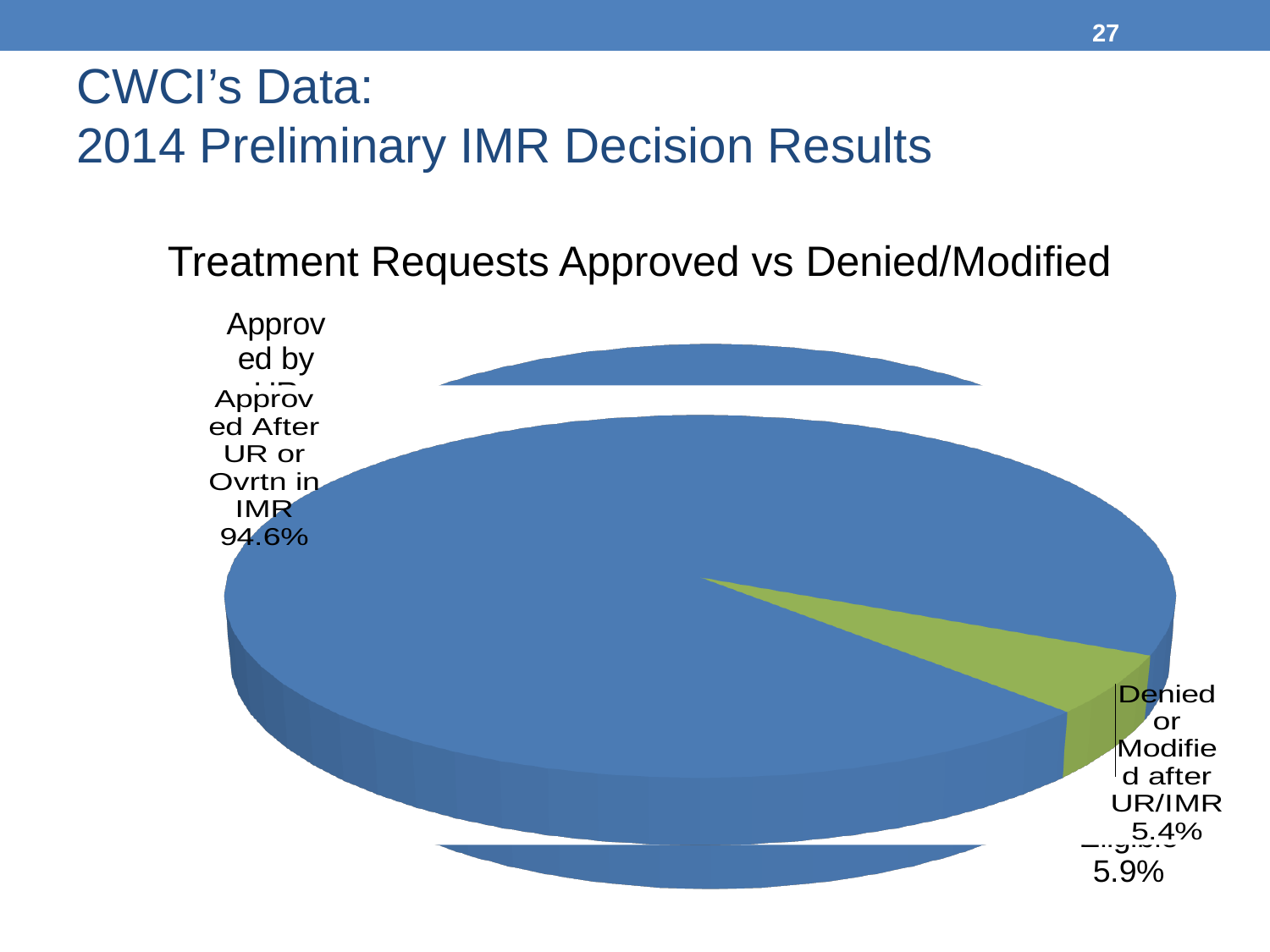
Which slice of the pie is the smallest? Denied or Modified after UR/IMR What colour is the Denied or Modified after UR/IMR slice? green What kind of chart is shown on the slide? pie chart Which is larger: the share Approved After UR or Ovrtn in IMR, or the share Denied or Modified after UR/IMR? Approved After UR or Ovrtn in IMR What share of the pie does the Approved After UR or Ovrtn in IMR slice represent? 94.6% Which slice of the pie is the largest? Approved After UR or Ovrtn in IMR What percentage of treatment requests were Approved After UR or Ovrtn in IMR? 94.6% What percentage of treatment requests were Denied or Modified after UR/IMR? 5.4% What is the difference in percentage points between the Approved After UR or Ovrtn in IMR slice and the Denied or Modified after UR/IMR slice? 89.2% What is the title of the chart? Treatment Requests Approved vs Denied/Modified